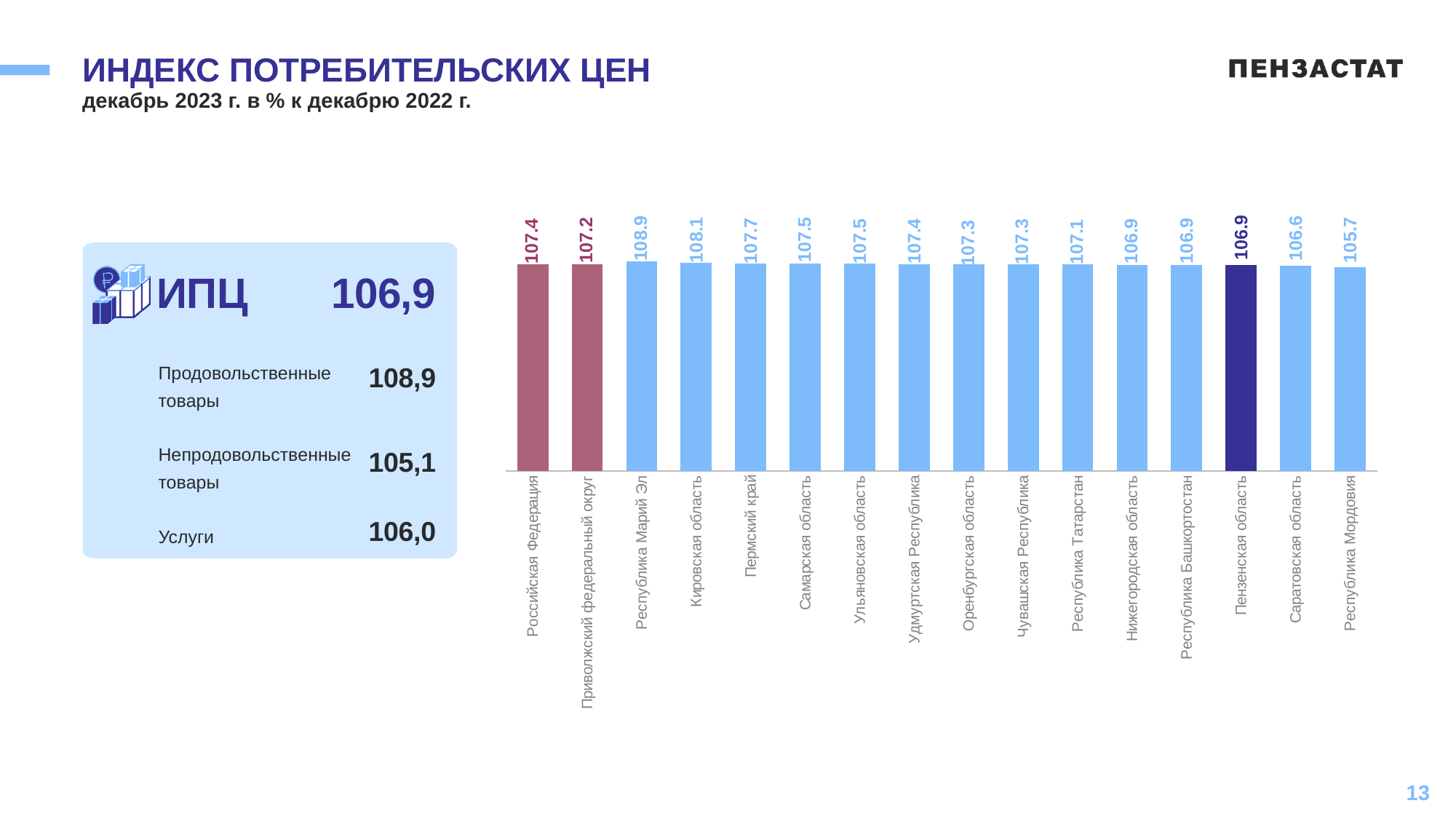
What is the value for Приволжский федеральный округ? 107.2 How many bars are shown in the chart? 16 What is the value for Российская Федерация? 107.4 Which category has the highest value? Республика Марий Эл What is the value for Кировская область? 108.1 Which bar is coloured dark blue, unlike the other regions? Пензенская область What is the value for Пензенская область? 106.9 What kind of chart is shown on the slide? Bar chart Which is larger, the value for Кировская область or the value for Республика Татарстан? Кировская область What is the difference between the values for Республика Марий Эл and Республика Мордовия? 3.2 What is the difference between the values for Пермский край and Саратовская область? 1.1 Which category has the lowest value? Республика Мордовия